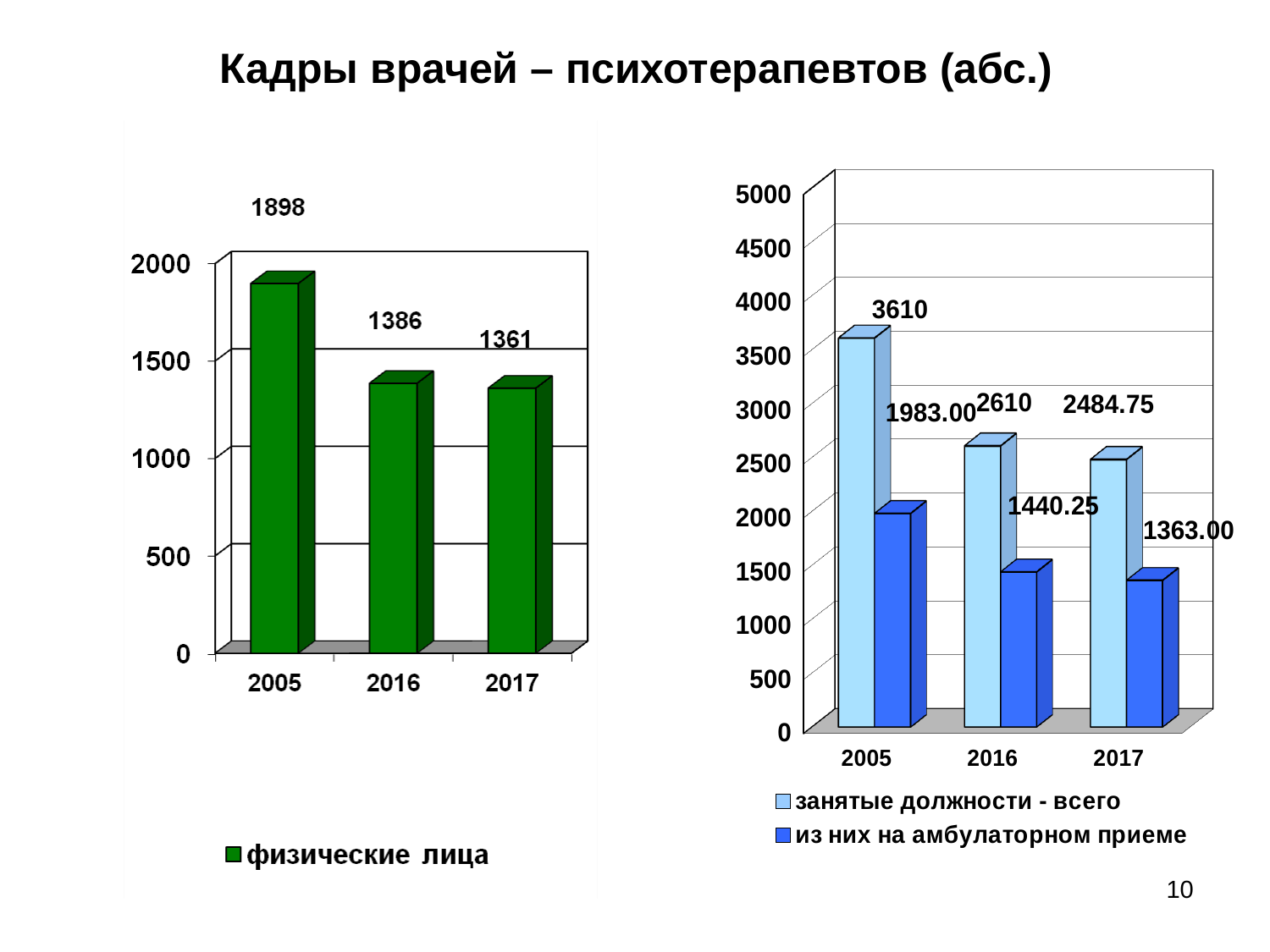
In the left chart, what is the value for физические лица in 2017? 1361 In the left chart, do the values rise or fall from 2005 to 2017? fall In the left chart, which year has the highest value? 2005 In the right chart, what is the value for занятые должности - всего in 2005? 3610 What kind of chart is the left chart? bar chart In the right chart, what is the value for занятые должности - всего in 2017? 2484.75 In the right chart, what is the difference between занятые должности - всего and из них на амбулаторном приеме in 2005? 1627.00 In the left chart, what is the difference between the 2005 and 2016 values? 512 In the right chart, which year has the lowest value for из них на амбулаторном приеме? 2017 How many series does the legend of the right chart list? 2 In the left chart, what is the value for физические лица in 2005? 1898 In the right chart, what is the value for из них на амбулаторном приеме in 2016? 1440.25